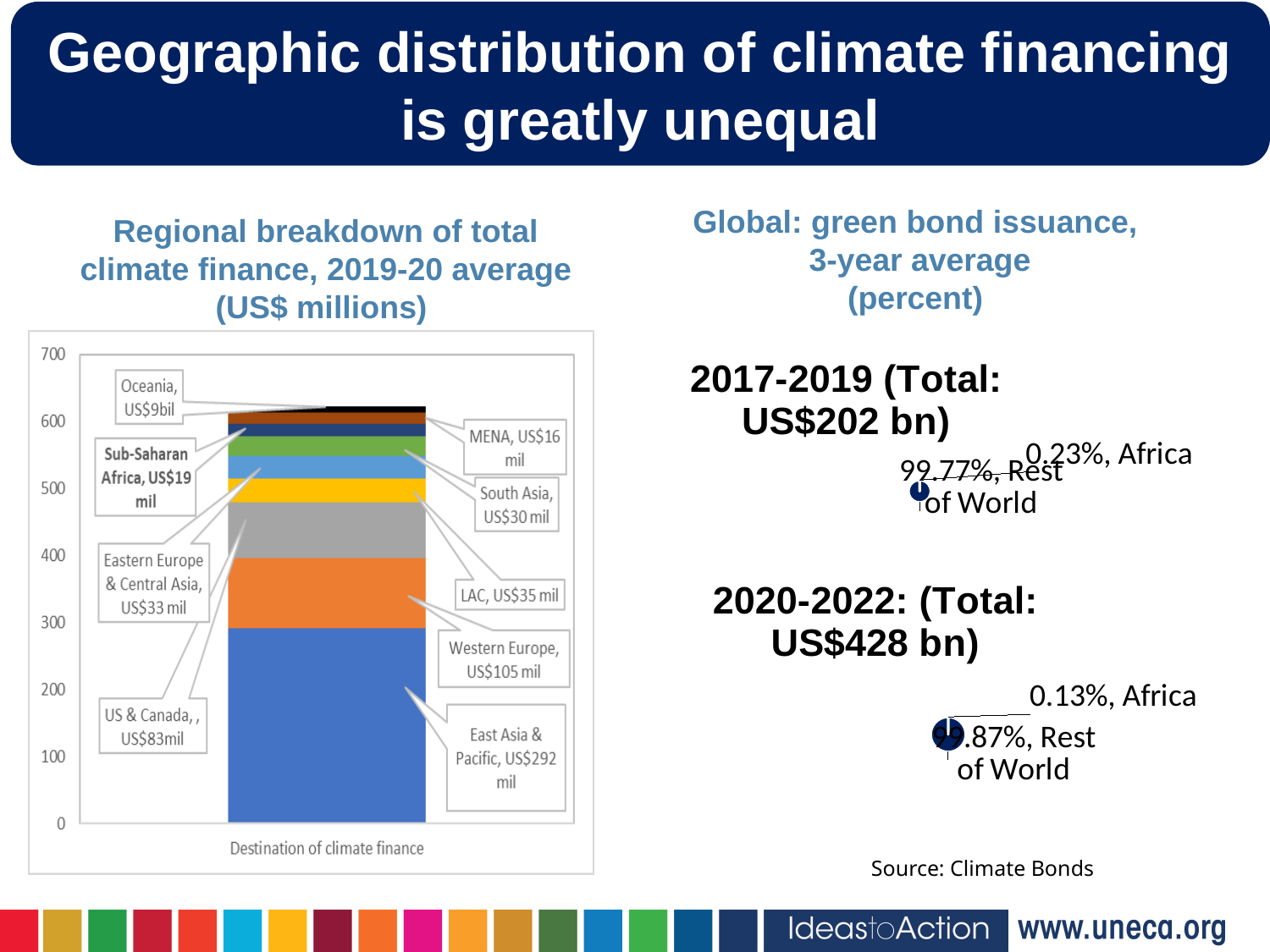
In the regional breakdown chart on the left, what is the value for Western Europe? US$105 mil In the regional breakdown chart on the left, what is the value for LAC? US$35 mil In the regional breakdown chart on the left, what is the value for East Asia & Pacific? US$292 mil In the regional breakdown chart on the left, how many regional segments make up the stacked bar? 9 In the green bond issuance chart for 2020-2022, what share of issuance went to the Rest of World? 99.87% In the regional breakdown chart on the left, what is the difference between East Asia & Pacific and Western Europe? US$187 mil What kind of charts are used for the green bond issuance data on the right? Pie charts In the green bond issuance chart for 2017-2019, what share of issuance went to Africa? 0.23% In the regional breakdown chart on the left, what is the value for Sub-Saharan Africa? US$19 mil What kind of chart is the regional breakdown chart on the left? Stacked bar chart In the regional breakdown chart on the left, which region receives the largest amount of climate finance? East Asia & Pacific In the regional breakdown chart on the left, which is larger, the value for Sub-Saharan Africa or the value for MENA? Sub-Saharan Africa